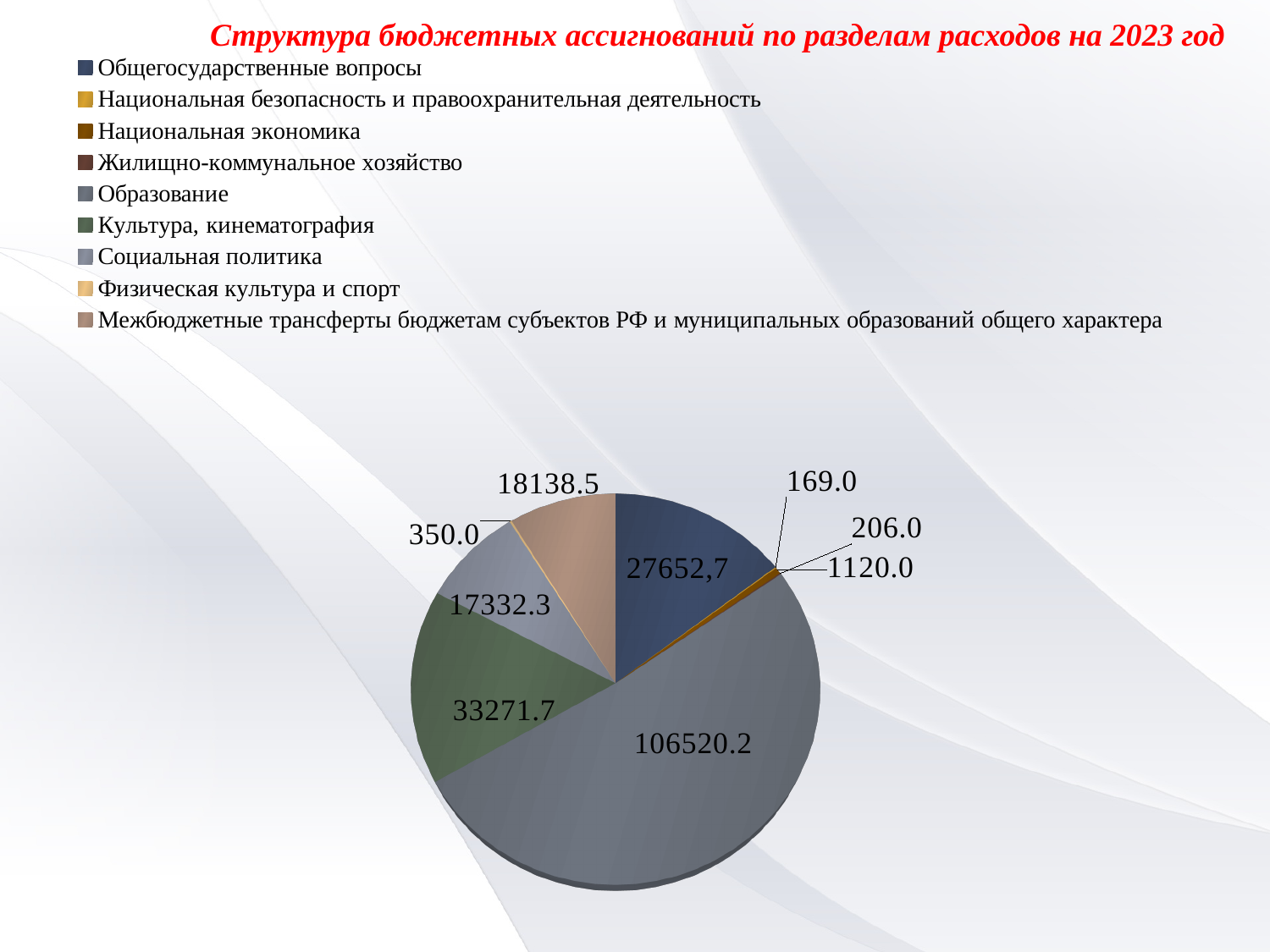
What type of chart is shown on the slide? pie chart What is the value for Общегосударственные вопросы? 27652,7 What is the title of the chart? Структура бюджетных ассигнований по разделам расходов на 2023 год What is the value for Образование? 106520.2 What is the value for Межбюджетные трансферты бюджетам субъектов РФ и муниципальных образований общего характера? 18138.5 What is the value for Социальная политика? 17332.3 Which is larger: Культура, кинематография or Социальная политика? Культура, кинематография How many categories does the legend list? 9 What is the smallest value labelled on the pie? 169.0 What is the difference between the values for Культура, кинематография and Социальная политика? 15939.4 Which category has the largest slice of the pie? Образование What is the value for Культура, кинематография? 33271.7